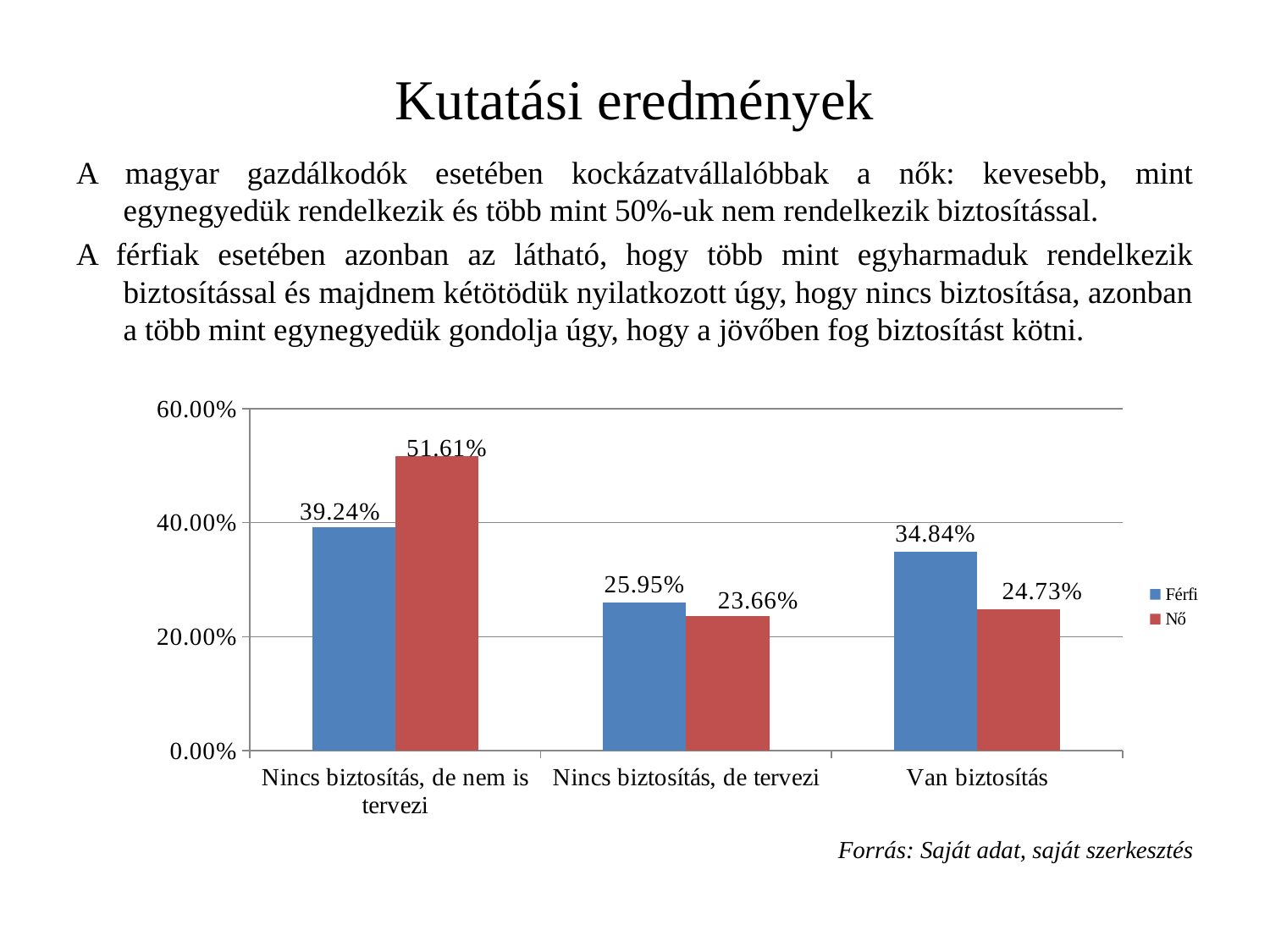
What kind of chart is shown on the slide? bar chart What is the value for Nő in the 'Nincs biztosítás, de nem is tervezi' category? 51.61% Is the value for Nő in the 'Nincs biztosítás, de nem is tervezi' category greater or less than 40.00%? greater What is the value for Férfi in the 'Nincs biztosítás, de nem is tervezi' category? 39.24% Which category has the highest value for the Nő series? Nincs biztosítás, de nem is tervezi In the 'Van biztosítás' category, which series has the larger value, Férfi or Nő? Férfi What is the difference between the Nő and Férfi values in the 'Nincs biztosítás, de nem is tervezi' category? 12.37% What is the value for Férfi in the 'Van biztosítás' category? 34.84% What is the value for Nő in the 'Nincs biztosítás, de tervezi' category? 23.66% Which category has the lowest value for the Férfi series? Nincs biztosítás, de tervezi How many series does the chart's legend list? 2 How many categories are shown on the x axis of the chart? 3